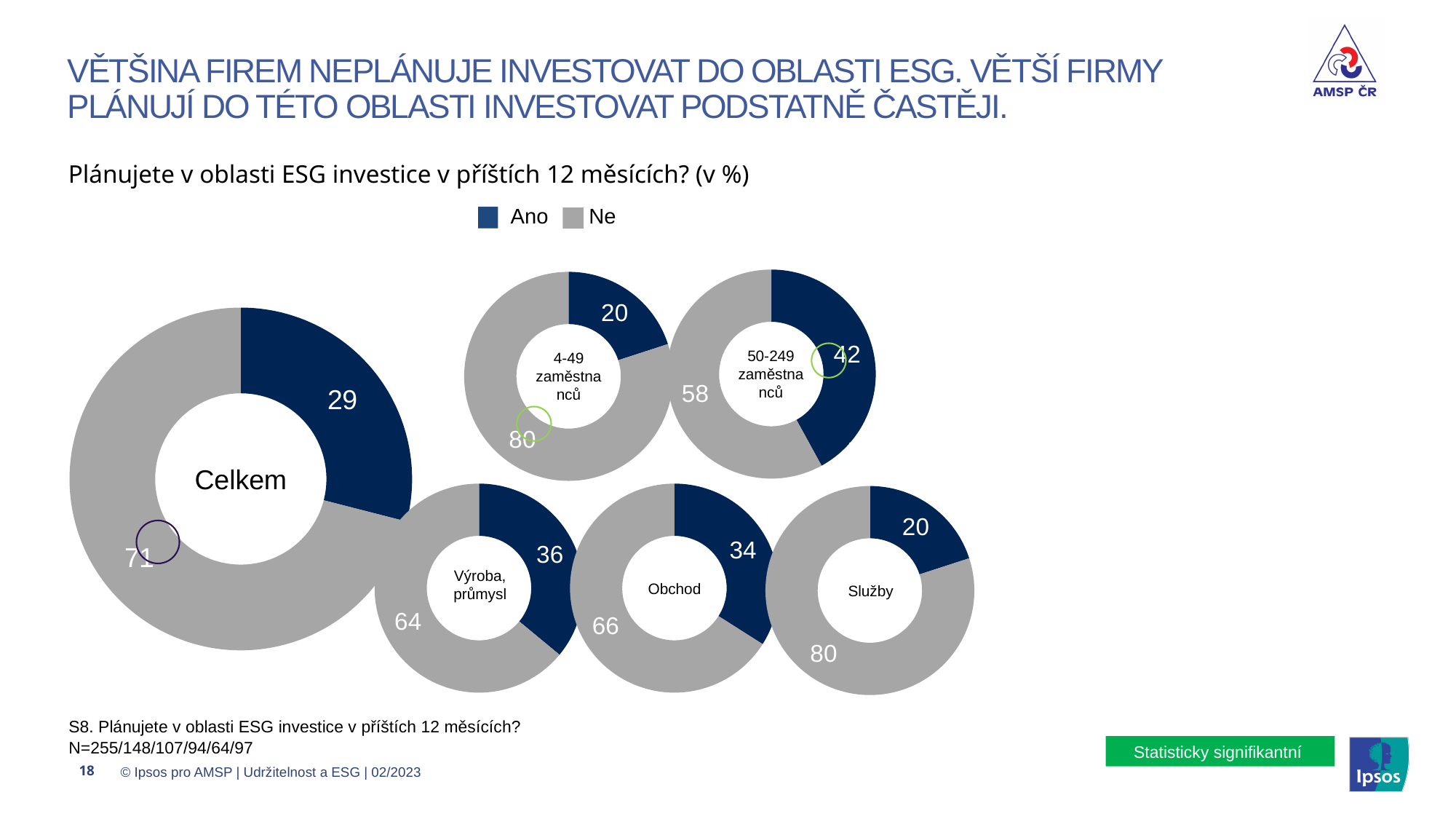
In the 'Služby' donut chart, what is the value for 'Ne'? 80 How many series does the legend list? 2 In the '4-49 zaměstnanců' donut chart, what is the value for 'Ne'? 80 In the '50-249 zaměstnanců' donut chart, what is the value for 'Ano'? 42 Across all the donut charts on the slide, which group has the highest 'Ano' value? 50-249 zaměstnanců In the 'Celkem' donut chart, what is the value for 'Ne'? 71 What type of chart is used on the slide? Donut (pie) chart In the 'Celkem' donut chart, what is the value for 'Ano'? 29 What is the difference between the 'Ano' values in the '50-249 zaměstnanců' chart and the '4-49 zaměstnanců' chart? 22 Which has the larger 'Ano' value: the 'Výroba, průmysl' chart or the 'Obchod' chart? Výroba, průmysl In the 'Obchod' donut chart, what is the value for 'Ano'? 34 How many donut charts are shown on the slide? 6